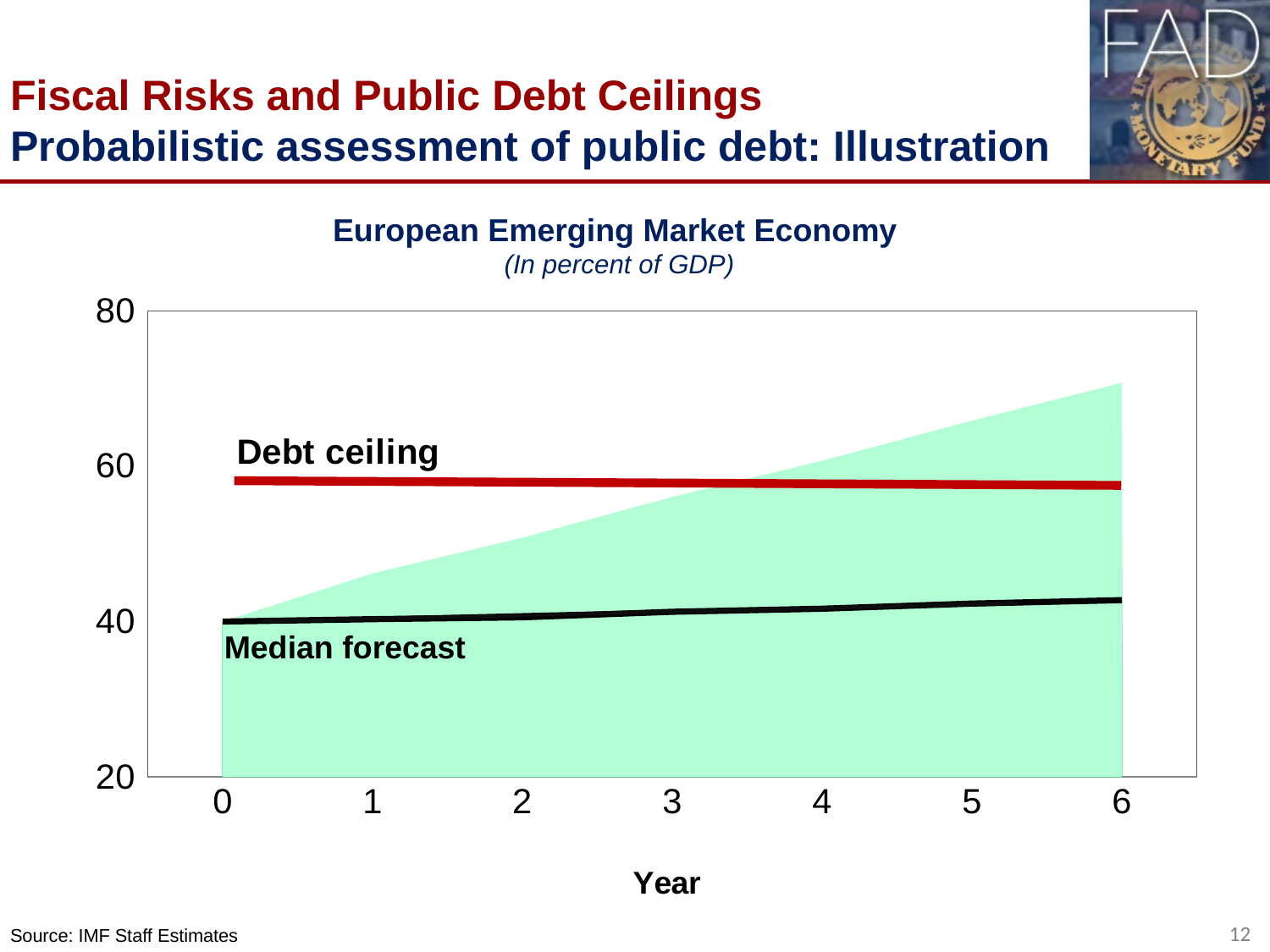
What is the label of the x axis? Year Is the value of the debt ceiling at year 3 greater or less than 60? less How many years are marked on the x axis? 7 Is the value of the debt ceiling at year 0 greater or less than 40? greater Is the upper edge of the shaded area at year 6 greater or less than 60? greater What kind of chart is shown on the slide? Combination area and line chart What is the title of the chart? European Emerging Market Economy Does the median forecast line rise or fall from year 0 to year 6? Rise At year 6, which is larger: the debt ceiling or the median forecast? Debt ceiling In what units are the values on the chart expressed, according to the subtitle? In percent of GDP